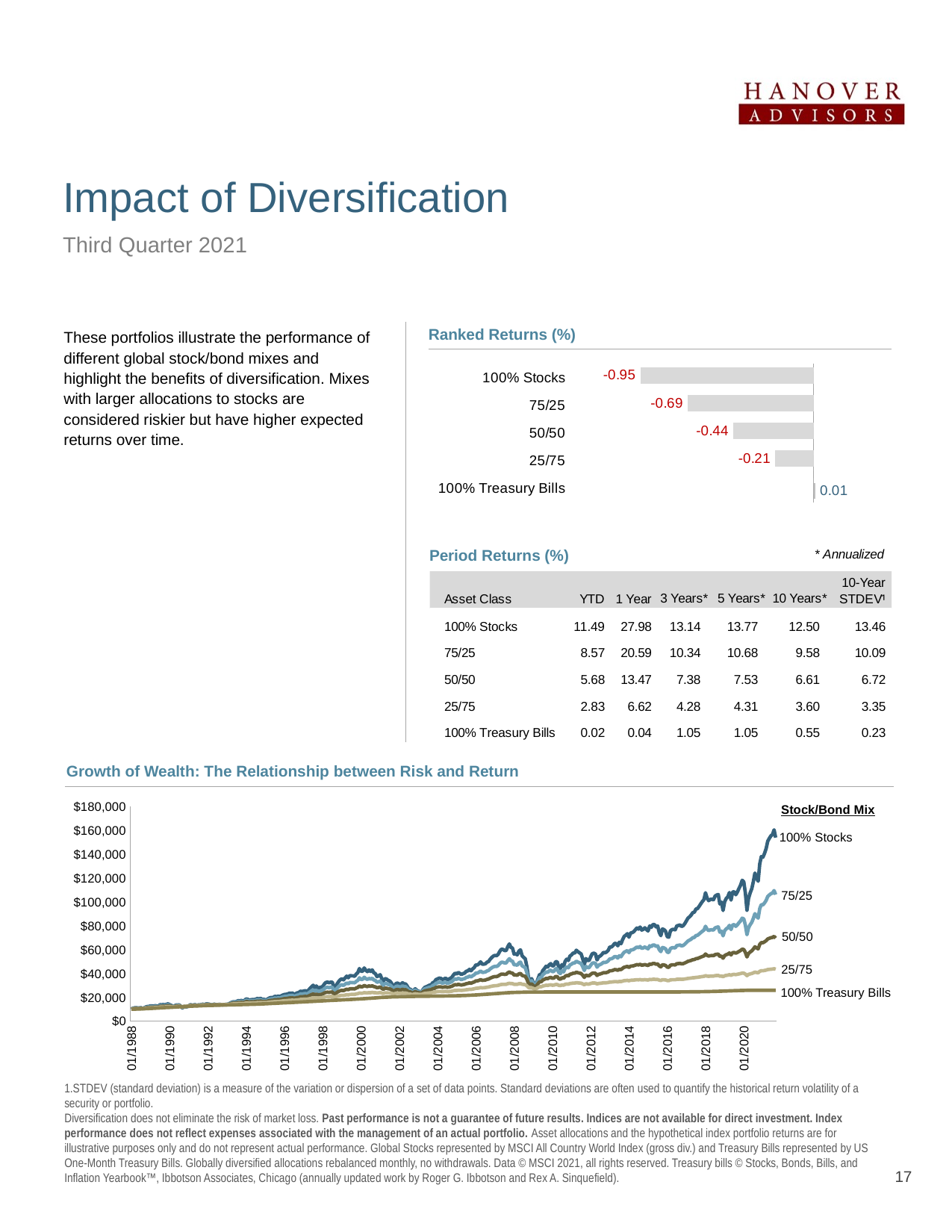
In the Ranked Returns (%) chart, what is the difference between the values for 75/25 and 25/75? 0.48 What kind of chart is the Ranked Returns (%) chart? Bar chart How many categories are shown in the Ranked Returns (%) chart? 5 In the Ranked Returns (%) chart, what is the value for 100% Stocks? -0.95 In the Ranked Returns (%) chart, which category has the highest value? 100% Treasury Bills In the Ranked Returns (%) chart, which is larger, the value for 50/50 or the value for 75/25? 50/50 In the Ranked Returns (%) chart, what is the value for 50/50? -0.44 How many series are labelled in the Growth of Wealth: The Relationship between Risk and Return chart? 5 In the Ranked Returns (%) chart, which category has the lowest value? 100% Stocks In the Growth of Wealth chart, is the final value of the 100% Stocks line greater or less than $140,000? greater What kind of chart is the Growth of Wealth: The Relationship between Risk and Return chart? Line chart In the Ranked Returns (%) chart, what is the value for 100% Treasury Bills? 0.01